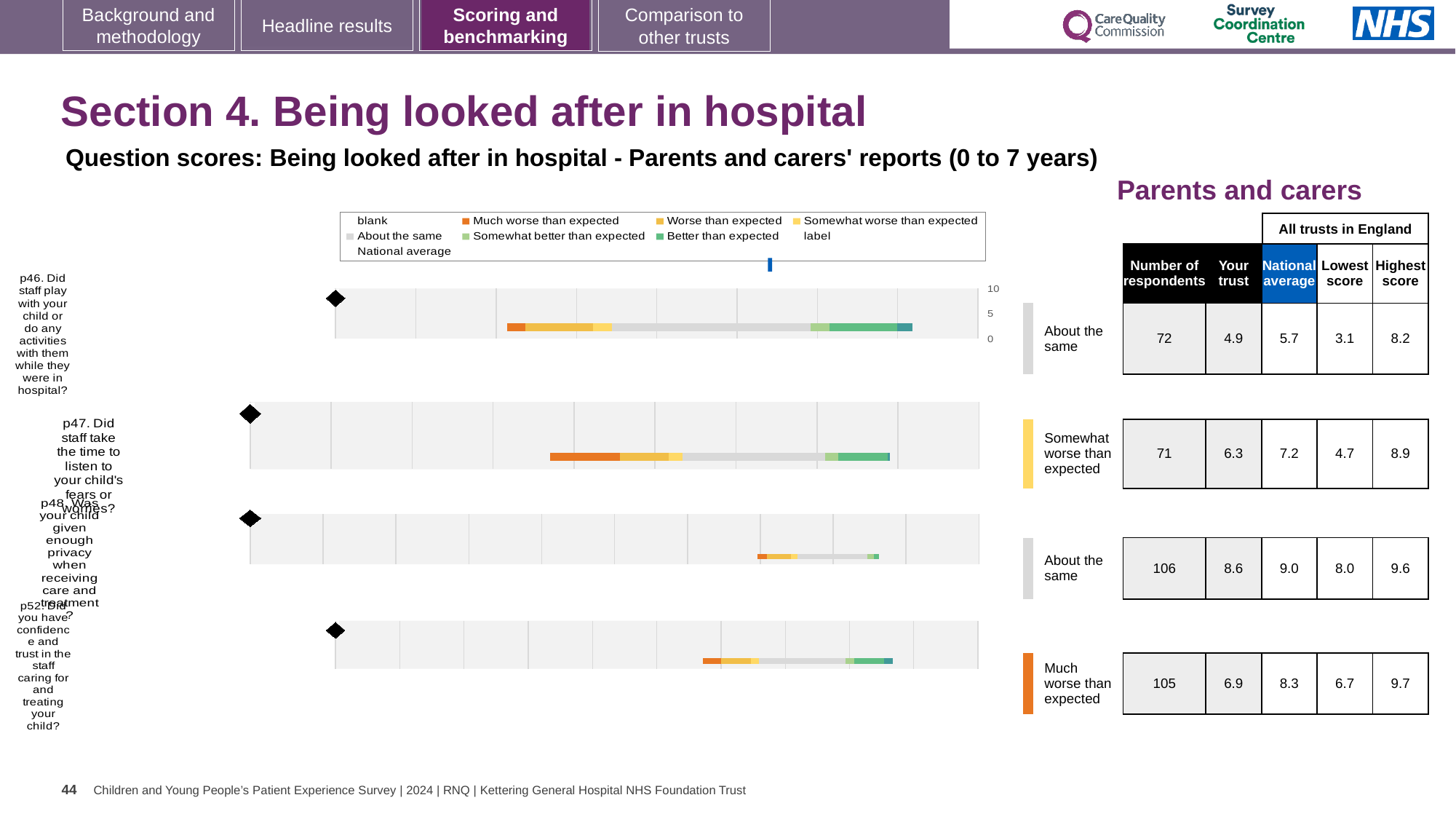
Which question chart has the highest 'Your trust' score? p48 How many question charts (p46, p47, p48, p52) are shown on the slide? 4 For the p48 chart, which is larger: the 'Your trust' score or the national average? National average What kind of chart is used for each question row (p46, p47, p48, p52) on this slide? bar chart For the p47 chart (Did staff take the time to listen to your child's fears or worries?), what is the national average shown in the table? 7.2 For the p46 chart (Did staff play with your child or do any activities with them while they were in hospital?), what is the 'Your trust' score shown in the table? 4.9 In the legend, what colour represents 'Much worse than expected'? Orange What benchmark category label is shown next to the p52 chart? Much worse than expected For the p52 chart (Did you have confidence and trust in the staff caring for and treating your child?), what is the highest score among all trusts in England? 9.7 For the p48 chart (Was your child given enough privacy when receiving care and treatment?), what is the number of respondents? 106 For the p46 chart, what is the difference between the highest score (8.2) and the lowest score (3.1)? 5.1 Which question chart has the lowest number of respondents? p47